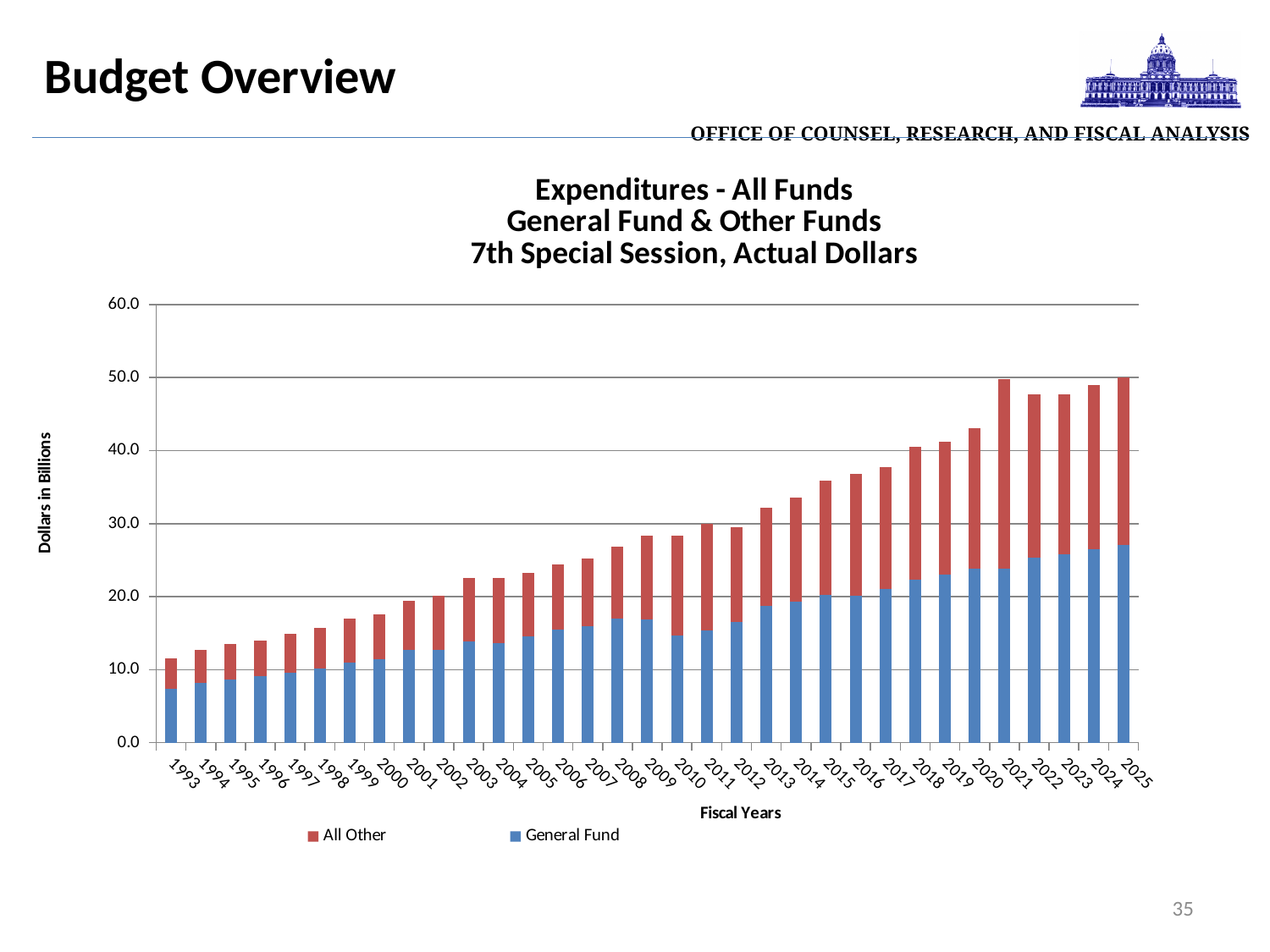
How many series does the legend list? 2 Which fiscal year has the larger total expenditure, 2010 or 2015? 2015 Which fiscal year has the lowest total expenditures? 1993 Is the total expenditure for 1993 greater or less than 10.0? greater Is the total expenditure for 2010 greater or less than 30.0? less Which two series are listed in the legend? All Other and General Fund Is the General Fund value for 2025 greater or less than 20.0? greater How many fiscal years are plotted on the x axis? 33 What kind of chart is shown on the slide? stacked bar chart Do total expenditures generally rise or fall from 1993 to 2025? rise